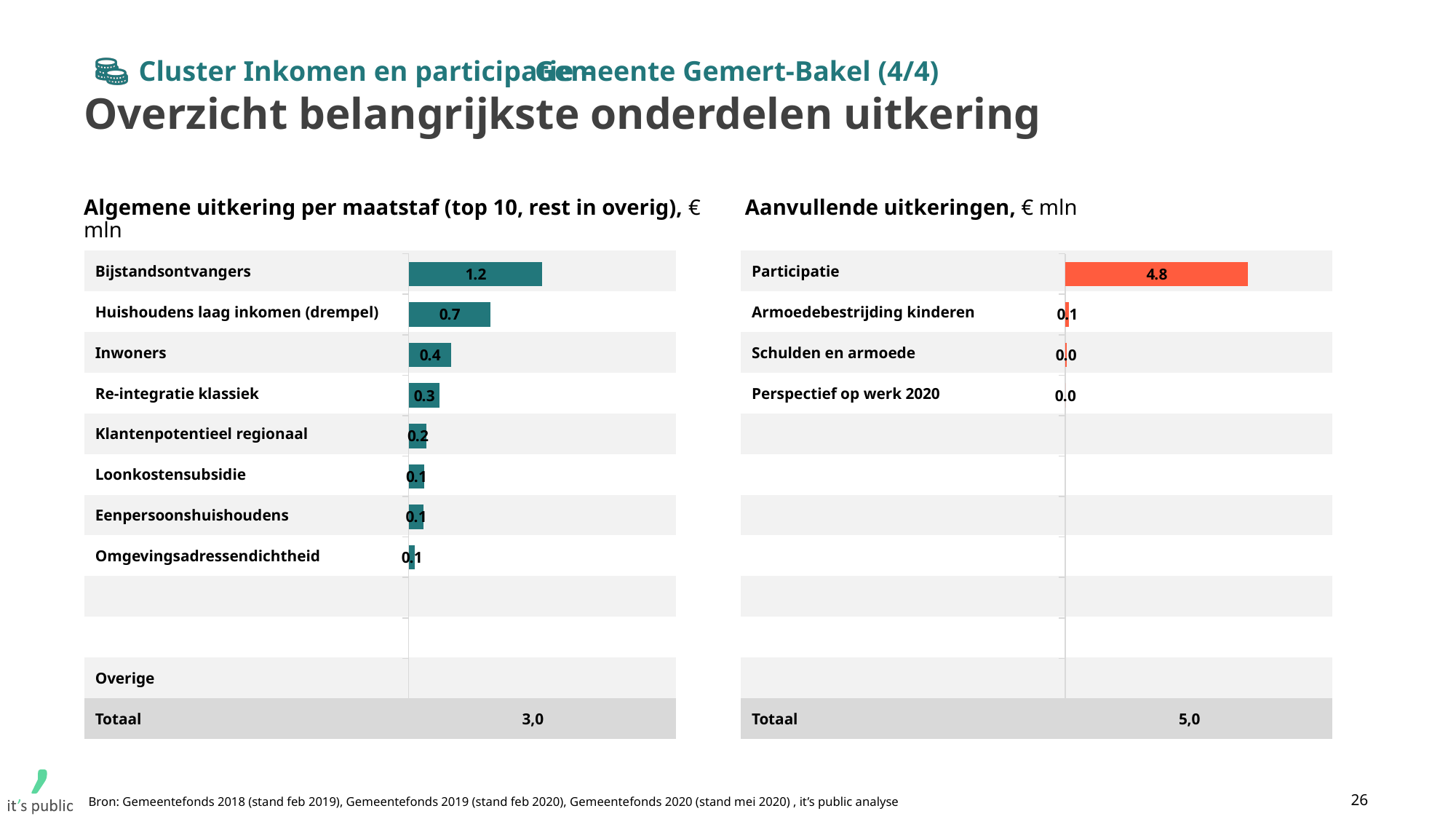
In the chart 'Aanvullende uitkeringen', which category has the highest value? Participatie What total is shown in the 'Totaal' row of the 'Aanvullende uitkeringen' chart? 5,0 In the chart 'Algemene uitkering per maatstaf', what is the difference between Bijstandsontvangers and Huishoudens laag inkomen (drempel)? 0.5 In the chart 'Algemene uitkering per maatstaf', what is the value for Bijstandsontvangers? 1.2 In the chart 'Aanvullende uitkeringen', what is the value for Participatie? 4.8 In the chart 'Algemene uitkering per maatstaf', which category has the highest value? Bijstandsontvangers In the chart 'Algemene uitkering per maatstaf', what is the value for Huishoudens laag inkomen (drempel)? 0.7 In the chart 'Aanvullende uitkeringen', how many categories are plotted? 4 In the chart 'Algemene uitkering per maatstaf', what is the value for Inwoners? 0.4 In the chart 'Algemene uitkering per maatstaf', which is larger: Inwoners or Re-integratie klassiek? Inwoners What kind of chart is the 'Aanvullende uitkeringen' chart? Bar chart In the chart 'Aanvullende uitkeringen', what is the value for Armoedebestrijding kinderen? 0.1